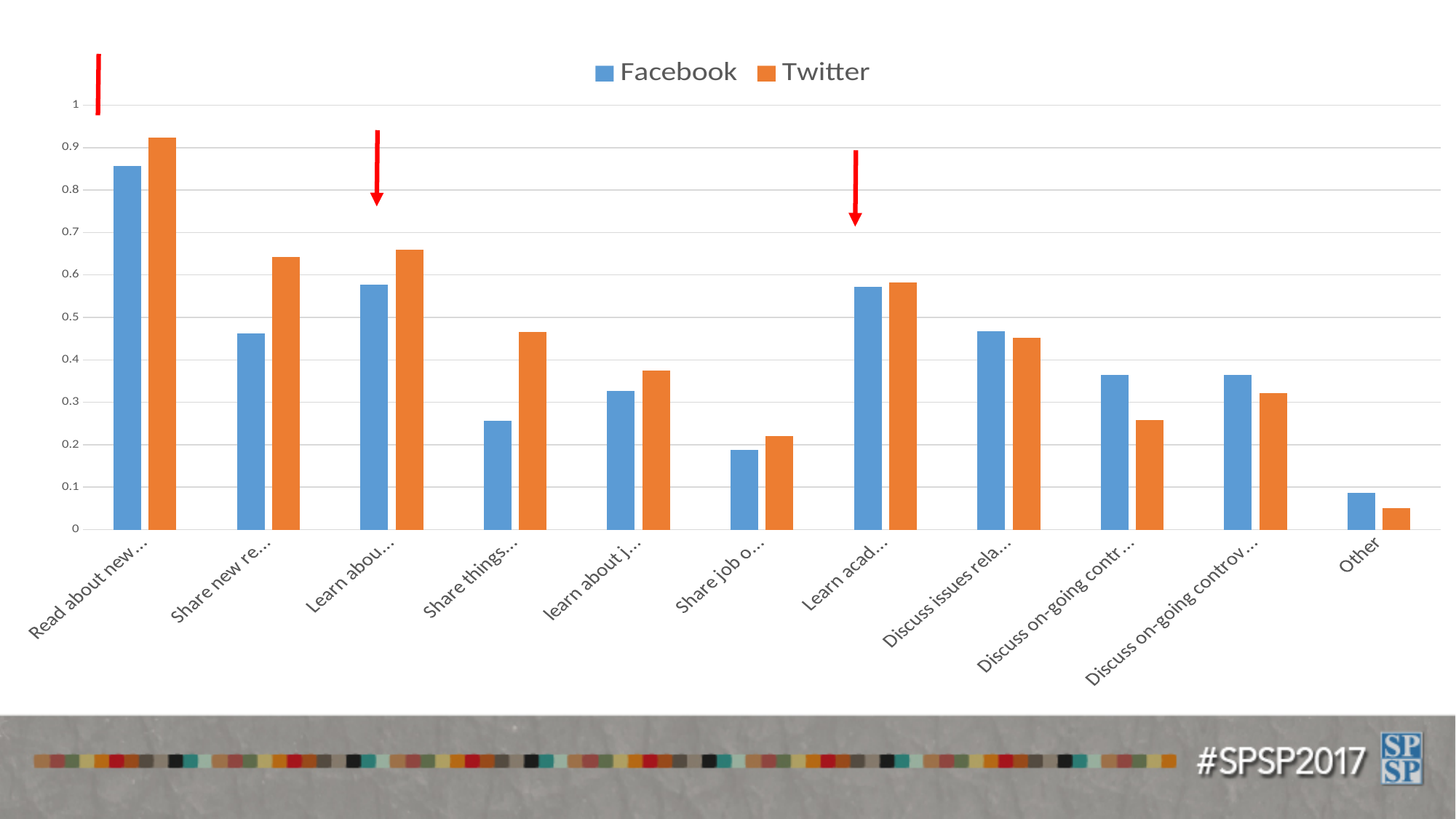
Which category has the lowest Facebook value? Other Is the Facebook value for Other greater or less than 0.1? less What kind of chart is shown on the slide? bar chart How many categories are shown along the x axis? 11 For the Other category, which is larger, the Facebook value or the Twitter value? Facebook Which category has the lowest Twitter value? Other How many series does the legend list? 2 Which two series are listed in the legend? Facebook and Twitter Which colour represents Twitter in the chart? orange Is the Facebook value for Other greater or less than 0.2? less Is the Twitter value for Other greater or less than 0.1? less